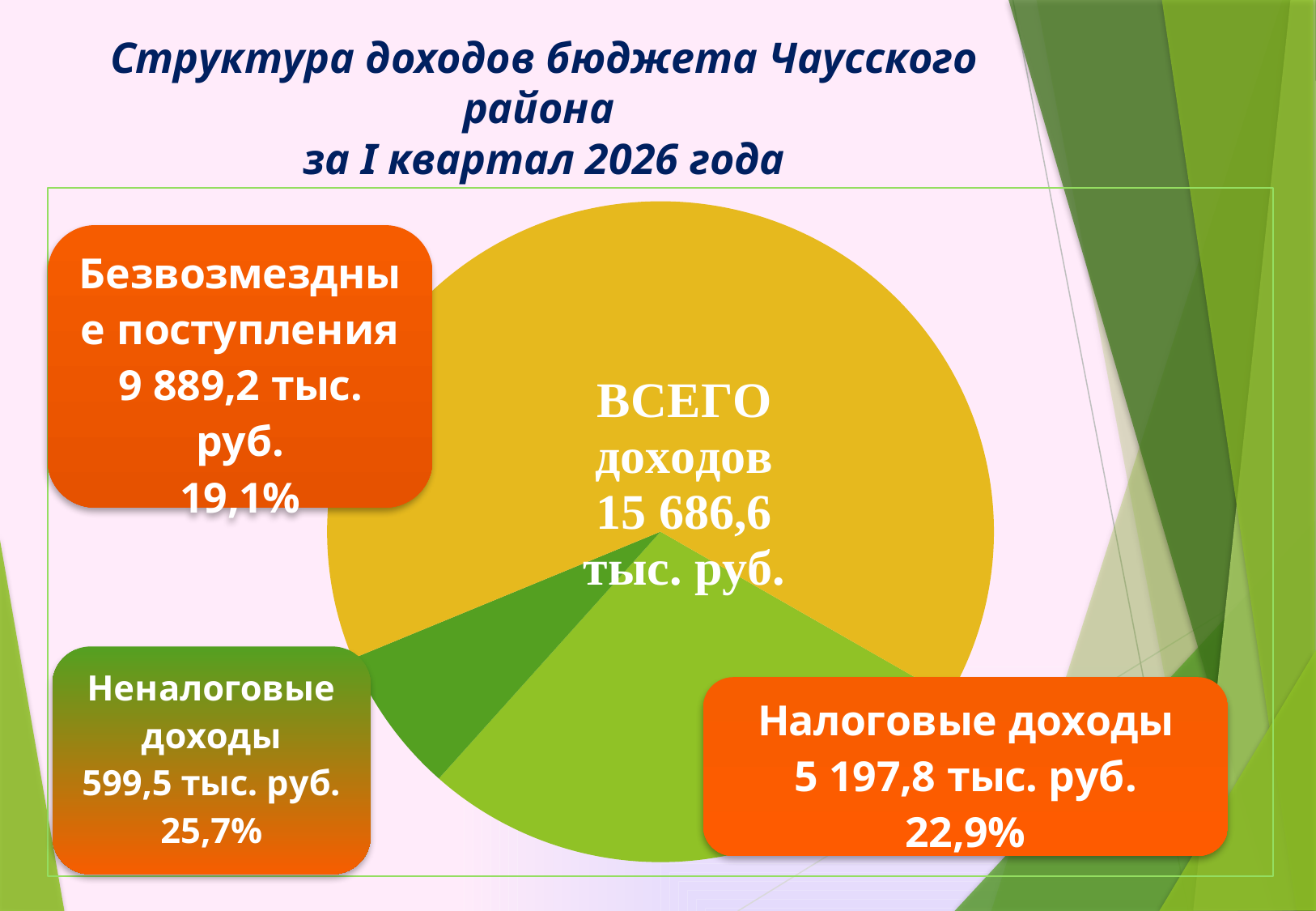
What is the total of all income (ВСЕГО доходов) shown in the centre of the pie chart? 15 686,6 тыс. руб. Which category has the smallest value? Неналоговые доходы What is the value shown for Налоговые доходы? 5 197,8 тыс. руб. Which is larger: Налоговые доходы or Неналоговые доходы? Налоговые доходы For which period does the chart show the budget income structure of Чаусский район? I квартал 2026 года How many categories (slices) does the pie chart have? 3 What is the value shown for Безвозмездные поступления? 9 889,2 тыс. руб. What is the difference between Безвозмездные поступления and Налоговые доходы? 4 691,4 тыс. руб. Which category has the largest value? Безвозмездные поступления What type of chart is shown on the slide? pie chart What percentage is printed in the label for Налоговые доходы? 22,9% What is the value shown for Неналоговые доходы? 599,5 тыс. руб.